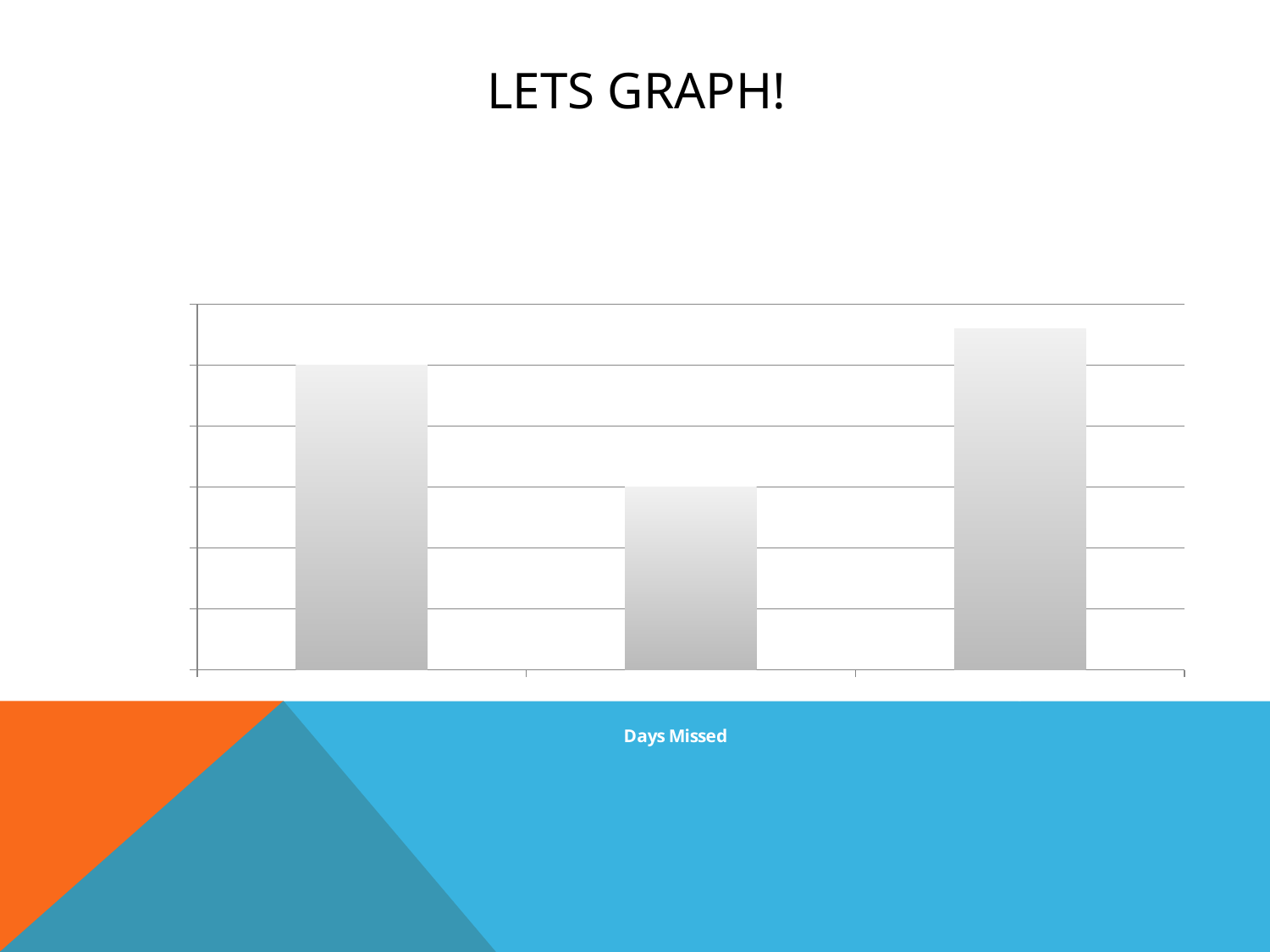
What kind of chart is shown on the slide? bar chart Is the right bar taller or shorter than the left bar? taller What is the title of the slide? LETS GRAPH! Is the left bar taller or shorter than the middle bar? taller Is the middle bar taller or shorter than the right bar? shorter Which bar is the shortest: the left, middle, or right bar? middle Which bar is the tallest: the left, middle, or right bar? right What is the axis title shown below the chart? Days Missed How many bars does the chart show? 3